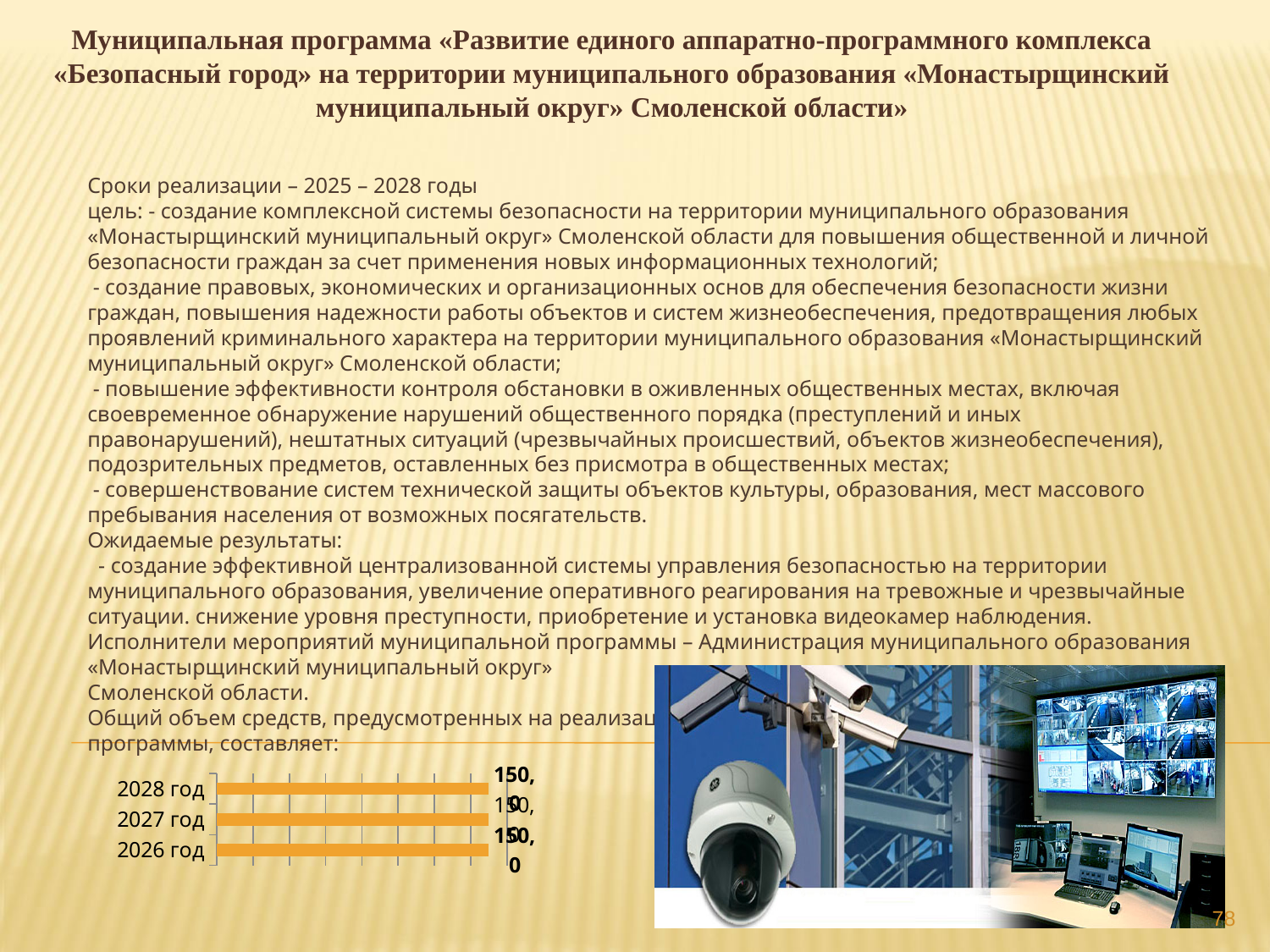
What is the value shown for 2027 год in the bar chart? 150,0 Which year is listed at the top of the bar chart? 2028 год What is the value shown for 2028 год in the bar chart? 150,0 How many categories (years) does the bar chart show? 3 Do the values in the bar chart rise, fall or stay the same from 2026 год to 2028 год? stay the same Are the bars in the chart horizontal or vertical? horizontal What is the value shown for 2026 год in the bar chart? 150,0 What kind of chart is shown at the bottom left of the slide? bar chart